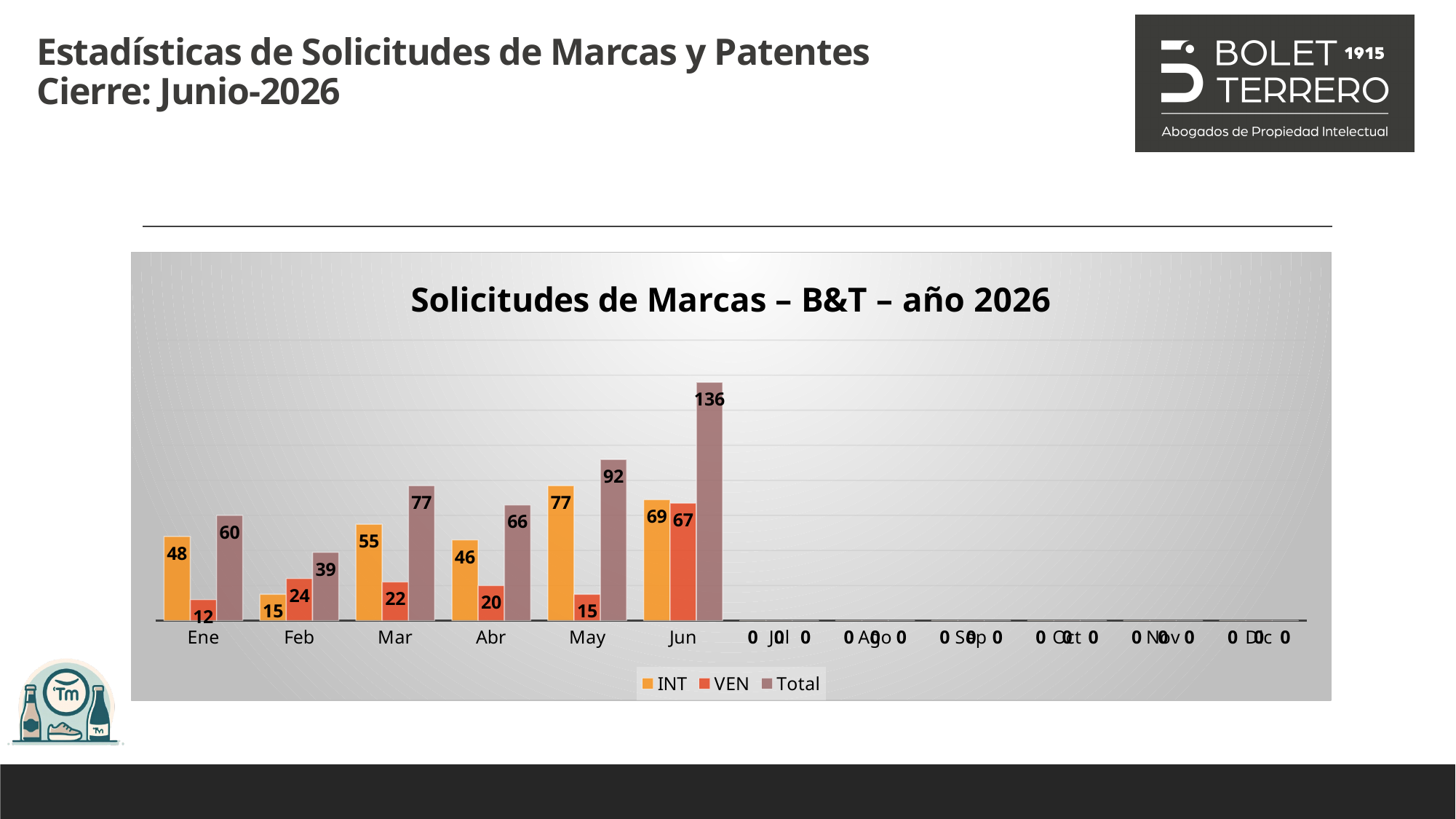
What is the title of the chart? Solicitudes de Marcas – B&T – año 2026 What type of chart is shown on the slide? Bar chart What is the Total value for May? 92 Which month has the highest Total value? Jun What is the VEN value for Feb? 24 Which month from Ene to Jun has the lowest INT value? Feb How many months are shown on the x axis? 12 What is the VEN value for Jun? 67 How many series does the legend list? 3 What is the INT value for Mar? 55 Which is larger, the INT value for Ene or the INT value for Abr? INT value for Ene What is the difference between the Total values for Jun and May? 44